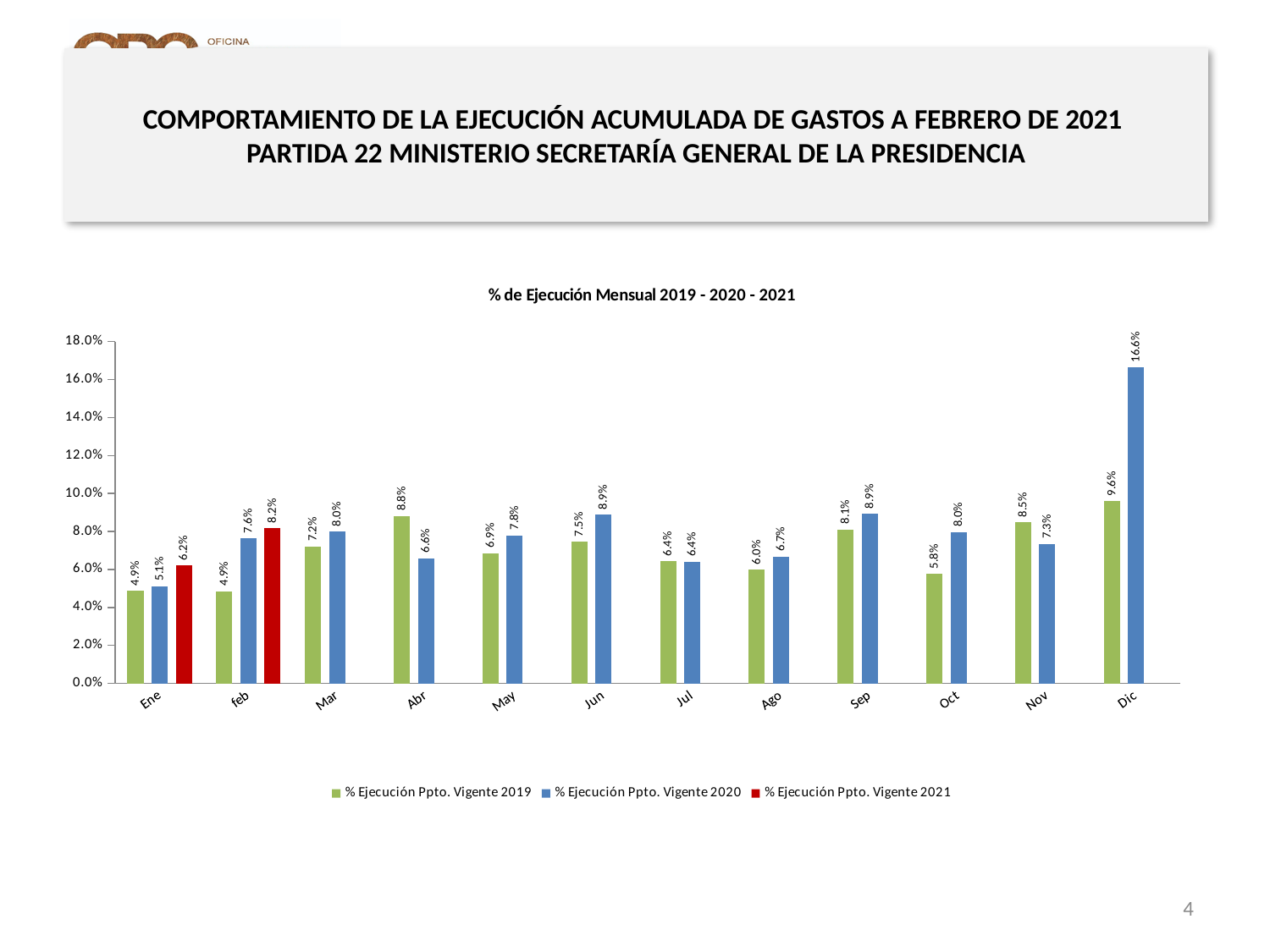
What is the value for % Ejecución Ppto. Vigente 2020 in Dic? 16.6% How many months are shown on the x axis? 12 Which is larger in Nov: the 2019 value or the 2020 value? 2019 (8.5%) Which month has the highest value for % Ejecución Ppto. Vigente 2020? Dic What is the difference between the 2020 and 2019 values in Dic? 7.0% What is the value for % Ejecución Ppto. Vigente 2021 in feb? 8.2% Is the value for % Ejecución Ppto. Vigente 2020 in Dic greater or less than 14.0%? greater What colour represents % Ejecución Ppto. Vigente 2021? Red How many series does the legend list? 3 What kind of chart is shown? Bar chart What is the value for % Ejecución Ppto. Vigente 2019 in Abr? 8.8% Which month has the lowest value for % Ejecución Ppto. Vigente 2019? Ene and feb (both 4.9%)